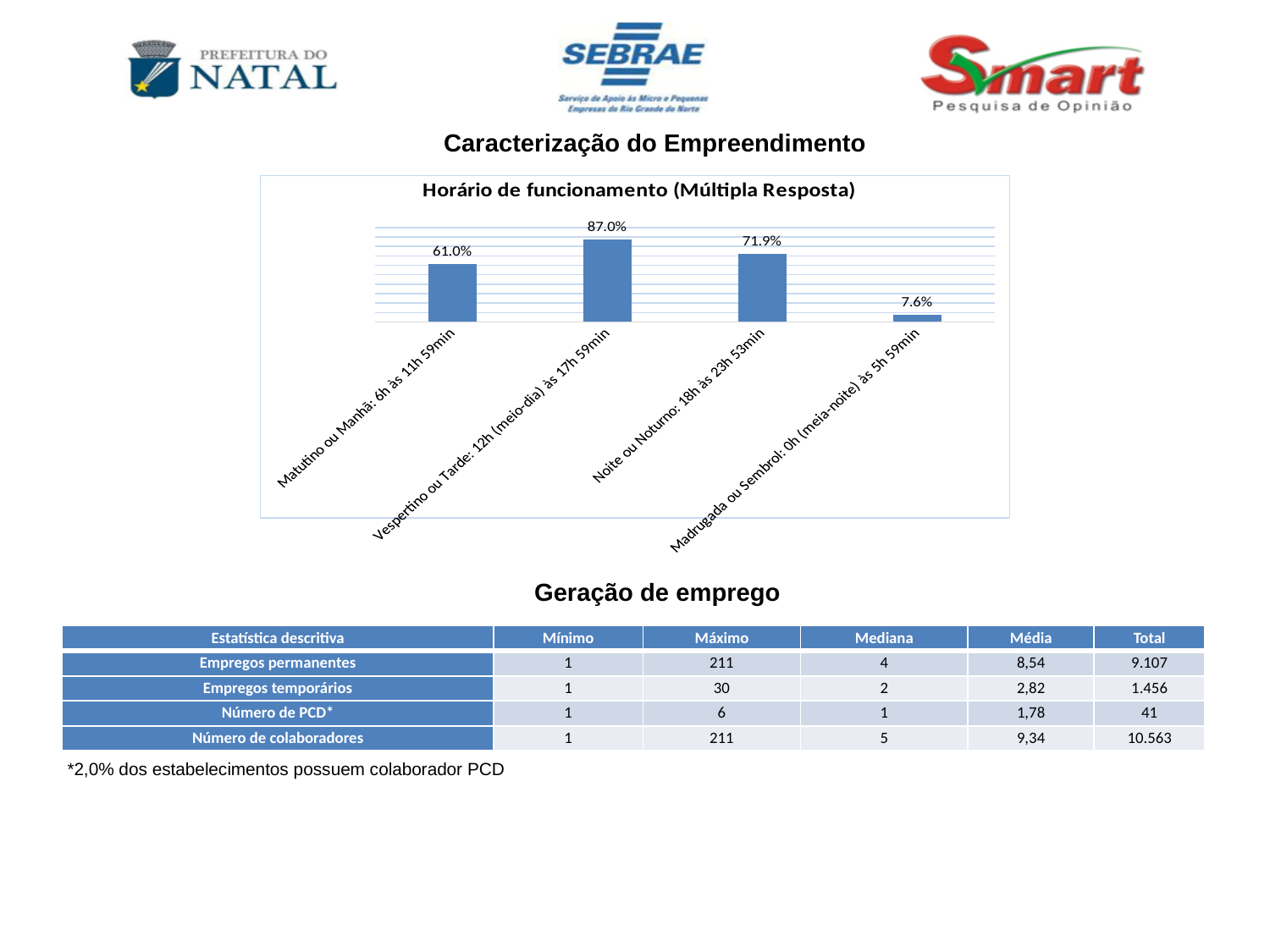
What type of chart is the Horário de funcionamento chart? Bar chart What is the title of the chart on the slide? Horário de funcionamento (Múltipla Resposta) Which category has the highest value in the Horário de funcionamento chart? Vespertino ou Tarde: 12h (meio-dia) às 17h 59min How many categories are shown in the Horário de funcionamento chart? 4 In the Horário de funcionamento chart, which is larger: Noite ou Noturno or Matutino ou Manhã? Noite ou Noturno Which category has the lowest value in the Horário de funcionamento chart? Madrugada ou Sembrol: 0h (meia-noite) às 5h 59min What is the value for Madrugada ou Sembrol: 0h (meia-noite) às 5h 59min in the Horário de funcionamento chart? 7.6% What is the difference between the Noite ou Noturno value and the Madrugada ou Sembrol value in the Horário de funcionamento chart? 64.3% What is the value for Noite ou Noturno: 18h às 23h 53min in the Horário de funcionamento chart? 71.9% What is the difference between the Vespertino ou Tarde value and the Matutino ou Manhã value in the Horário de funcionamento chart? 26.0% What is the value for Matutino ou Manhã: 6h às 11h 59min in the Horário de funcionamento chart? 61.0% What is the value for Vespertino ou Tarde: 12h (meio-dia) às 17h 59min in the Horário de funcionamento chart? 87.0%